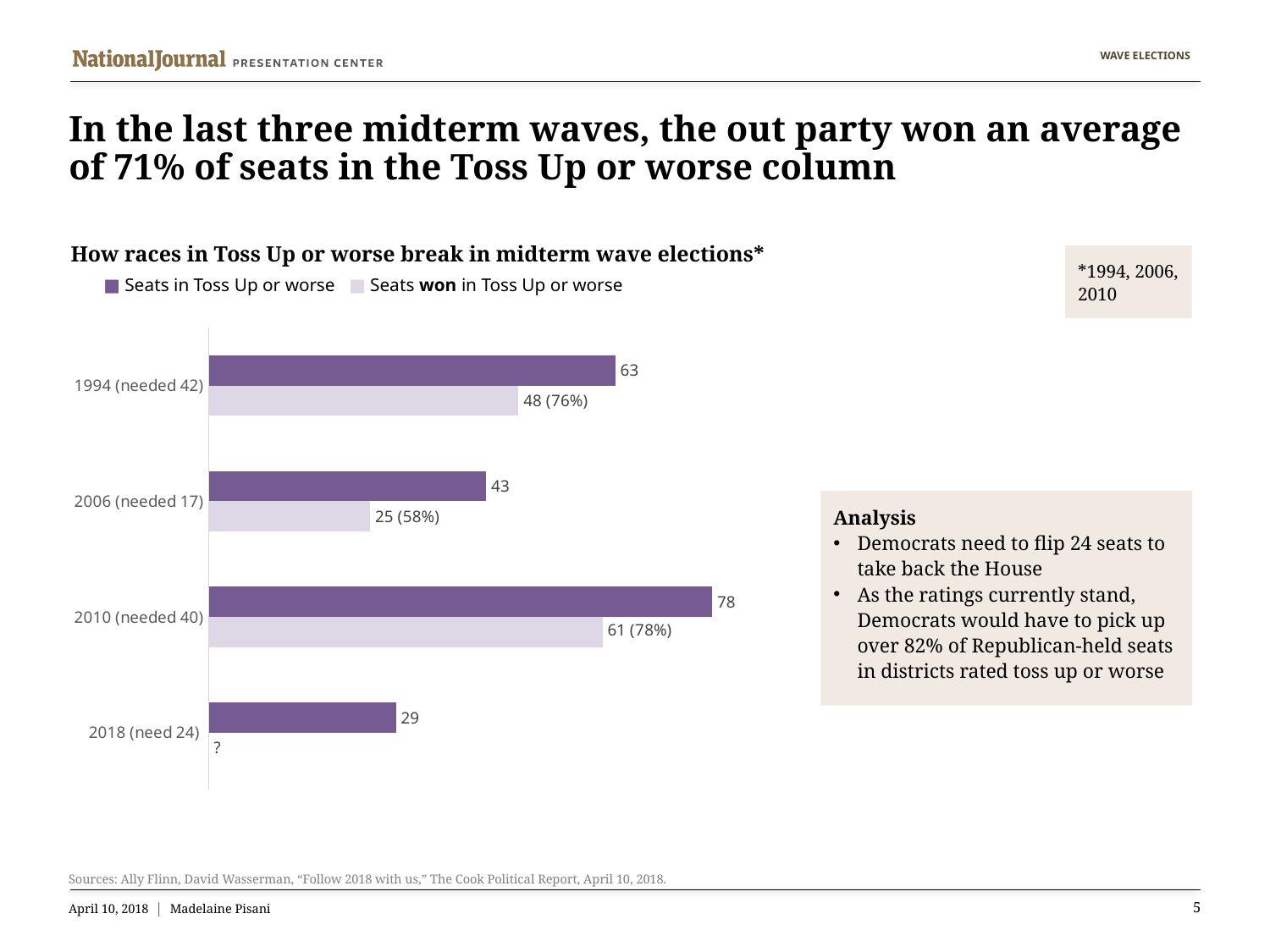
What is the value for Seats in Toss Up or worse for 2010 (needed 40)? 78 How many categories are shown on the chart? 4 How many series does the legend list? 2 Which category has the highest value for Seats in Toss Up or worse? 2010 (needed 40) What is the title of the chart? How races in Toss Up or worse break in midterm wave elections* What is the difference between Seats in Toss Up or worse and Seats won in Toss Up or worse for 2010 (needed 40)? 17 What kind of chart is shown on the slide? Bar chart Which is larger: Seats in Toss Up or worse for 1994 (needed 42) or for 2006 (needed 17)? 1994 (needed 42) What is the value for Seats in Toss Up or worse for 2018 (need 24)? 29 Which category has the lowest value for Seats in Toss Up or worse? 2018 (need 24) What is the data label for Seats won in Toss Up or worse for 2006 (needed 17)? 25 (58%) What is the data label for Seats won in Toss Up or worse for 1994 (needed 42)? 48 (76%)